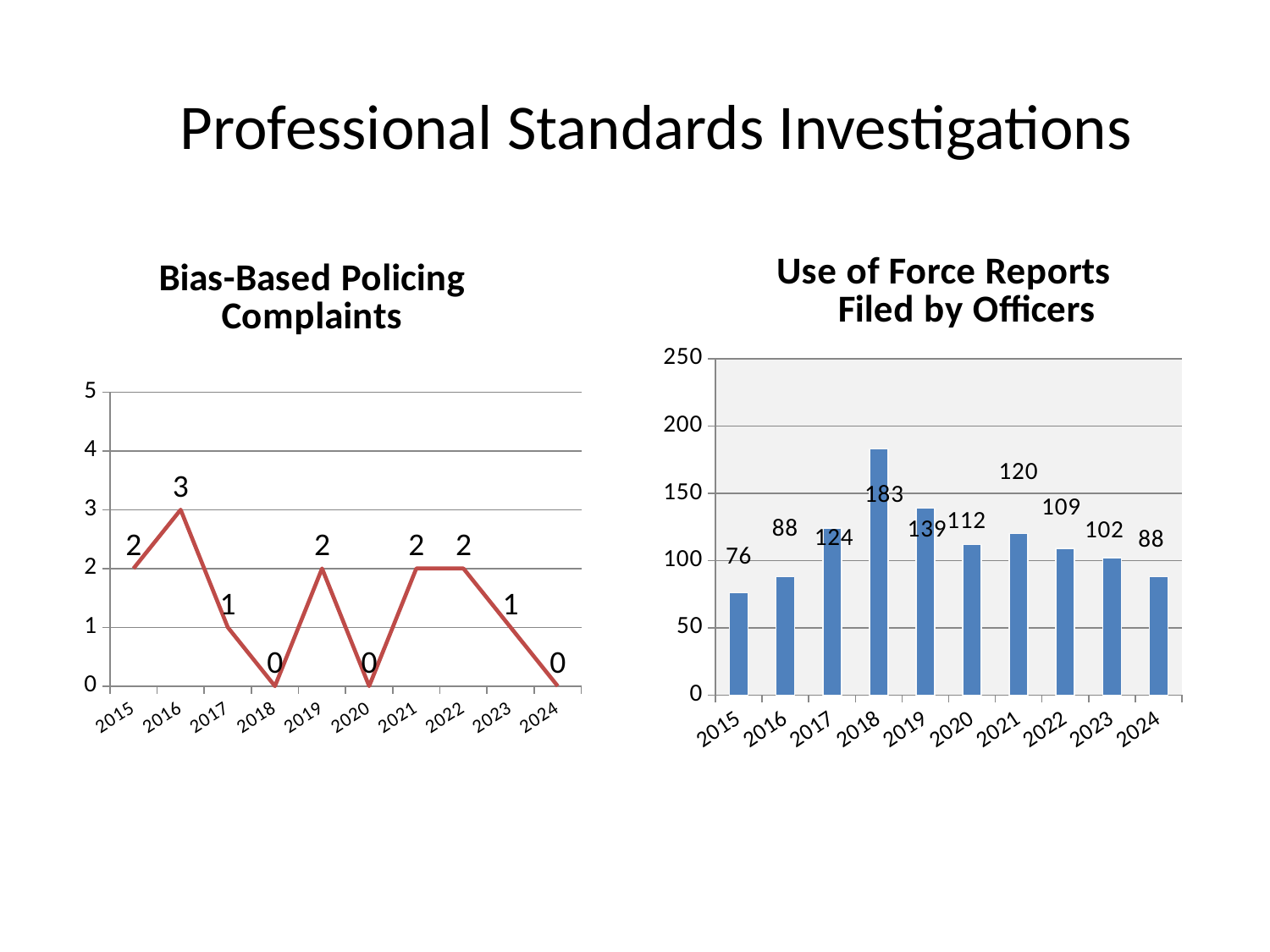
In the Bias-Based Policing Complaints chart, what is the value for 2016? 3 What kind of chart is the Use of Force Reports Filed by Officers chart? Bar chart In the Use of Force Reports Filed by Officers chart, what is the difference between the values for 2018 and 2019? 44 In the Bias-Based Policing Complaints chart, how many years are plotted on the x axis? 10 In the Use of Force Reports Filed by Officers chart, is the value for 2017 greater or less than 100? greater In the Use of Force Reports Filed by Officers chart, which year has the lowest value? 2015 In the Use of Force Reports Filed by Officers chart, which is larger, the value for 2021 or the value for 2022? 2021 In the Bias-Based Policing Complaints chart, what is the value for 2023? 1 In the Use of Force Reports Filed by Officers chart, what is the value for 2024? 88 In the Use of Force Reports Filed by Officers chart, what is the value for 2018? 183 What kind of chart is the Bias-Based Policing Complaints chart? Line chart In the Bias-Based Policing Complaints chart, which year has the highest value? 2016